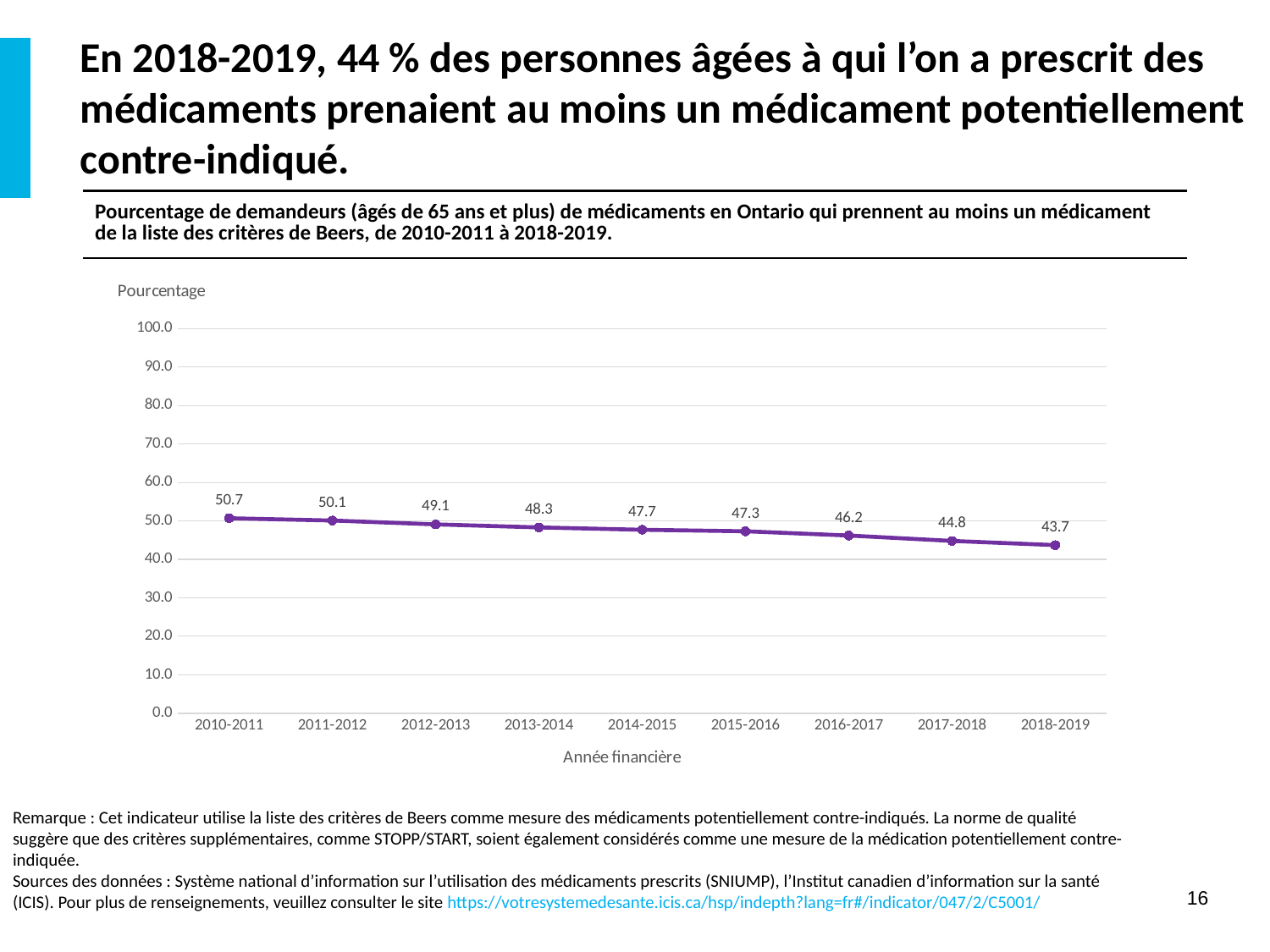
Do the values rise or fall from 2010-2011 to 2018-2019? fall Is the value for 2017-2018 greater or less than 50.0? less What is the value for 2018-2019? 43.7 What is the label of the x axis? Année financière What is the difference between the values for 2010-2011 and 2018-2019? 7.0 How many fiscal years are plotted on the chart? 9 What is the value for 2014-2015? 47.7 Which is larger, the value for 2012-2013 or the value for 2016-2017? 2012-2013 Which fiscal year has the lowest value? 2018-2019 What kind of chart is shown on the slide? line chart What is the value for 2010-2011? 50.7 Which fiscal year has the highest value? 2010-2011